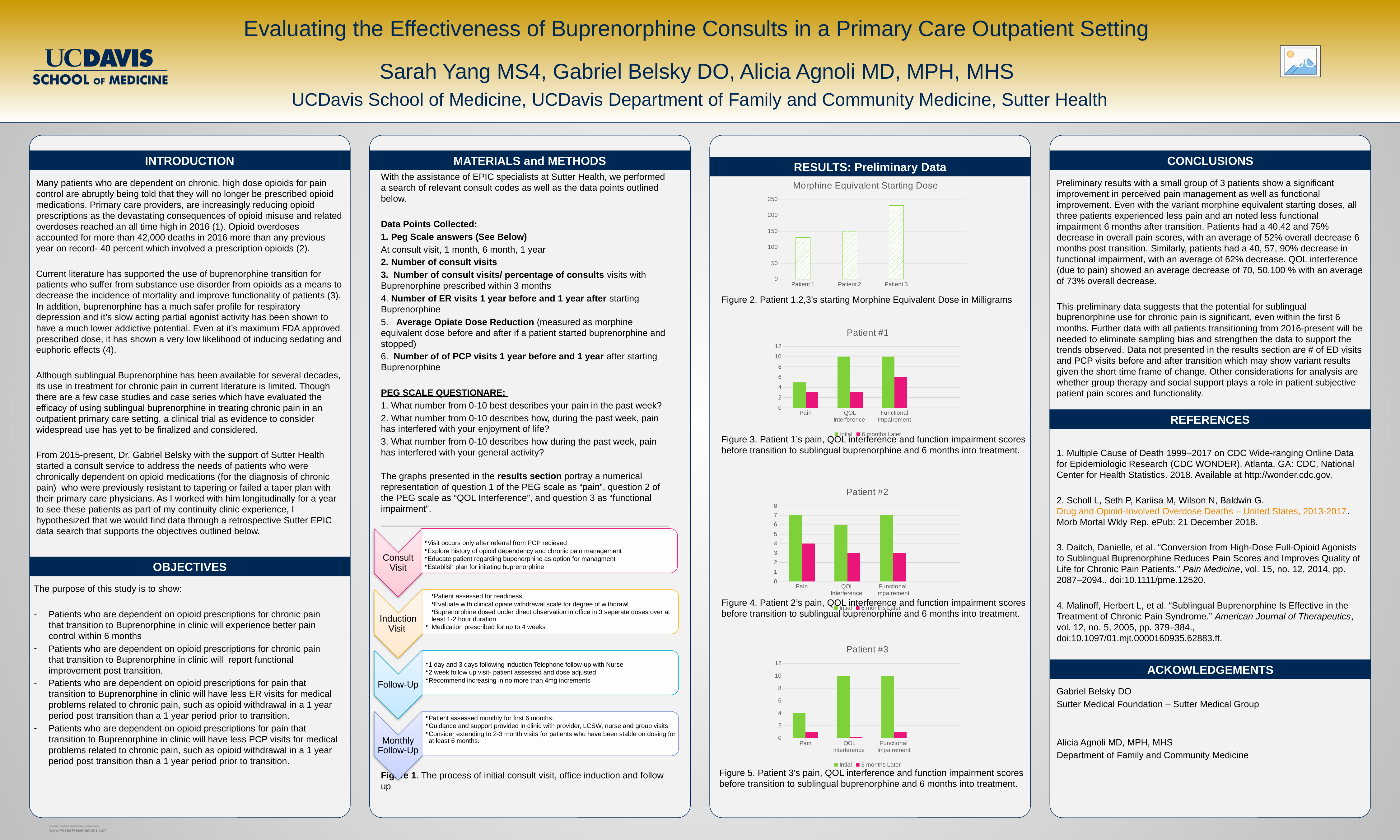
In the 'Patient #2' chart, which category has the lowest Initial value? QOL Interference In the 'Morphine Equivalent Starting Dose' chart, is the value for Patient 3 greater or less than 200? greater In the 'Patient #1' chart, what is the 6 months Later value for Functional Impairment? 6 In the 'Patient #3' chart, what is the Initial value for QOL Interference? 10 In the 'Morphine Equivalent Starting Dose' chart, is the value for Patient 1 greater or less than 100? greater In the 'Patient #2' chart, what is the difference between the Initial and 6 months Later values for QOL Interference? 3 In the 'Patient #1' chart, what is the Initial value for Functional Impairment? 10 In the 'Patient #2' chart, what is the Initial value for Pain? 7 What kind of chart is the 'Morphine Equivalent Starting Dose' chart? bar chart In the 'Patient #3' chart, which is larger: the Initial value for Pain or the Initial value for Functional Impairment? Functional Impairment How many series does the legend of the 'Patient #1' chart list? 2 In the 'Morphine Equivalent Starting Dose' chart, which patient has the highest starting dose? Patient 3